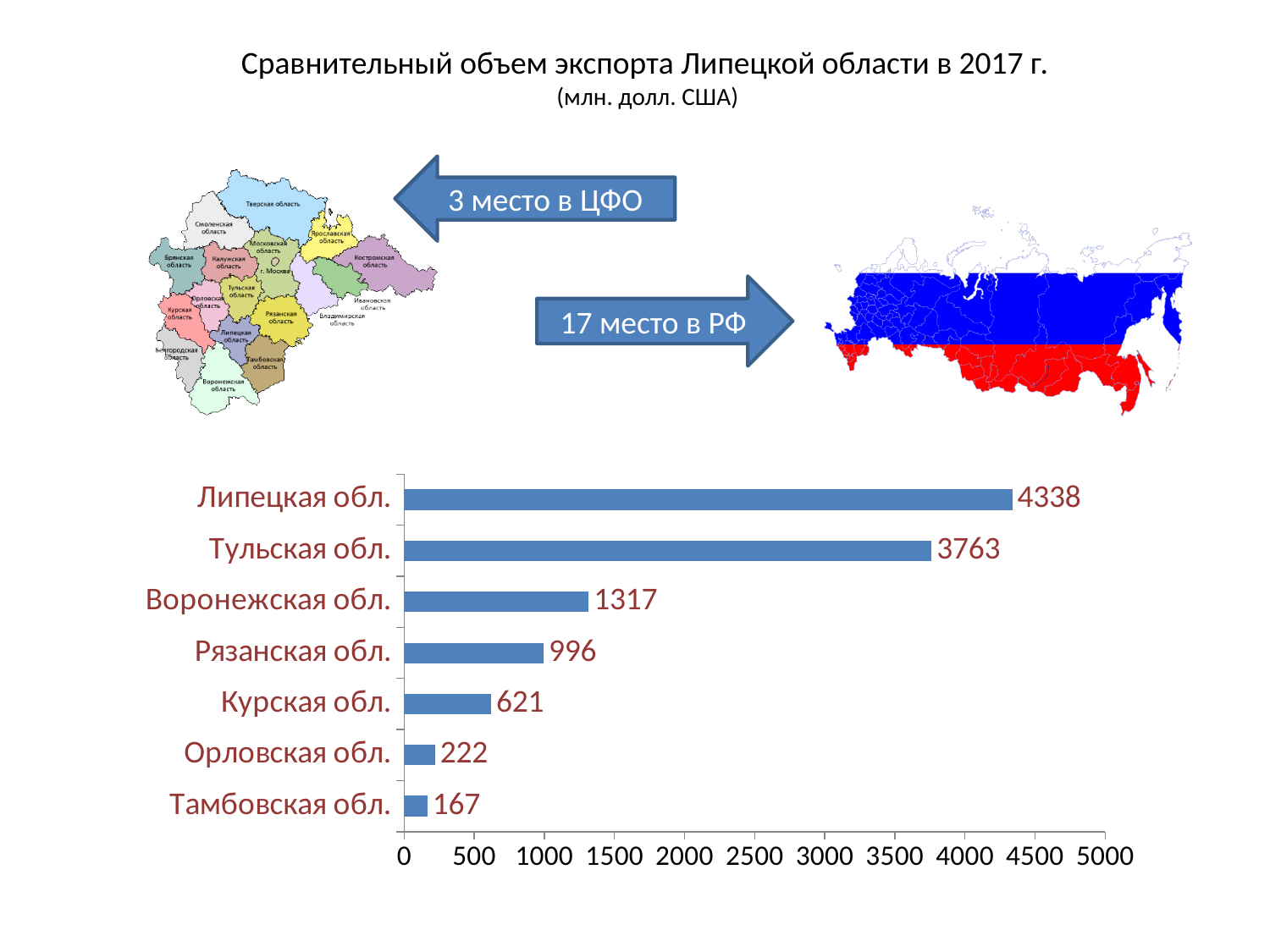
Which is larger, the value for Рязанская обл. or the value for Курская обл.? Рязанская обл. Which region has the highest export volume on the chart? Липецкая обл. What is the maximum value shown on the horizontal axis of the chart? 5000 How many regions are shown on the chart? 7 What value is shown for Воронежская обл.? 1317 Which region has the lowest export volume on the chart? Тамбовская обл. What is the export volume shown for Липецкая обл.? 4338 What is the difference between the values for Липецкая обл. and Тульская обл.? 575 What value is shown for Тамбовская обл.? 167 Is the value for Тульская обл. greater or less than 3500? greater What kind of chart is shown on the slide? bar chart What is the difference between the values for Курская обл. and Орловская обл.? 399